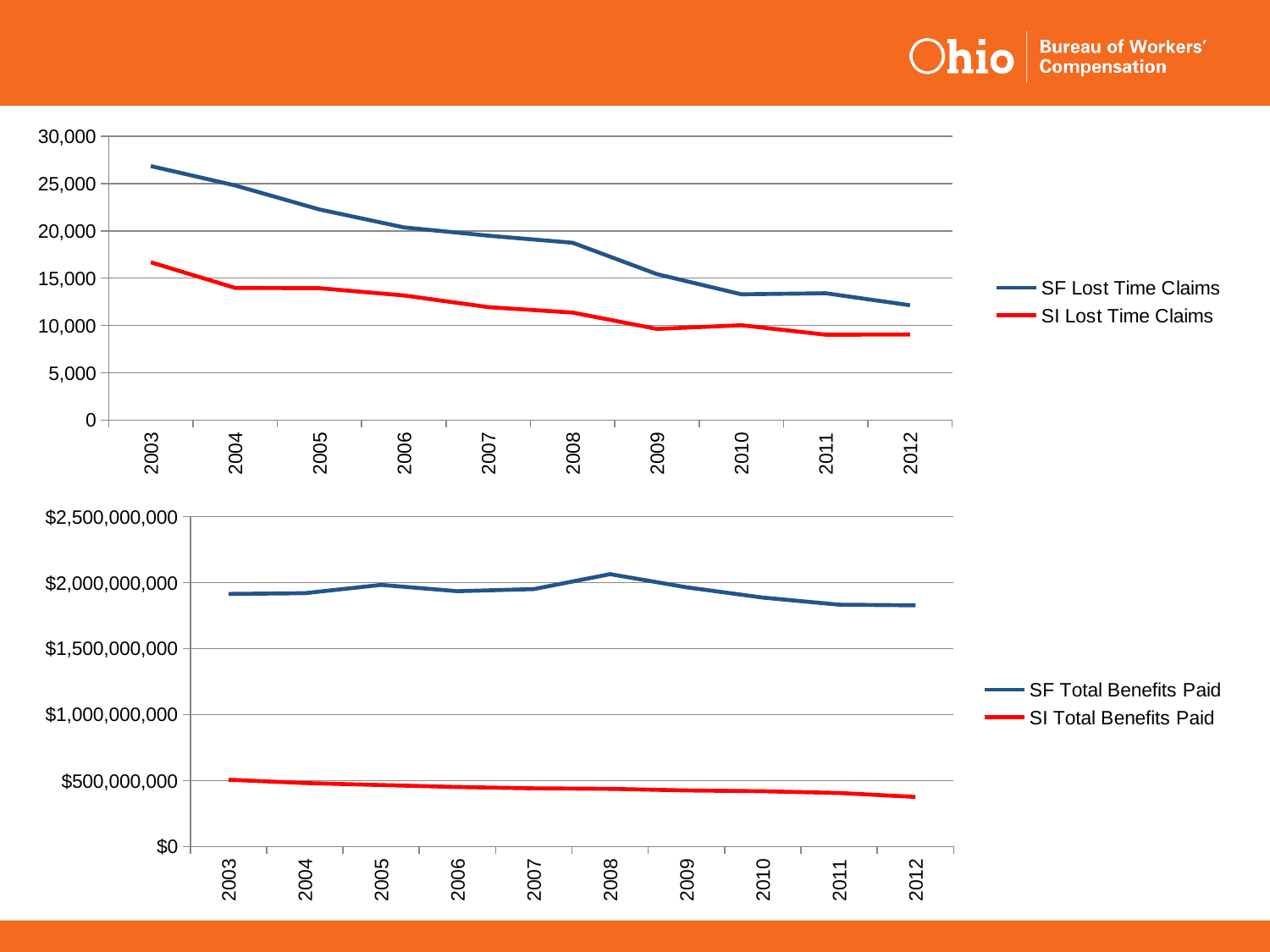
How many years are shown on the x axis of the bottom chart? 10 In the top chart, is the value for SI Lost Time Claims in 2012 greater or less than 10,000? less In the bottom chart, is the value for SI Total Benefits Paid in 2012 greater or less than $500,000,000? less In the top chart, which series is higher in 2008, SF Lost Time Claims or SI Lost Time Claims? SF Lost Time Claims In the top chart, which year has the lowest value for SF Lost Time Claims? 2012 In the bottom chart, what colour is the line for SI Total Benefits Paid? red How many series does the legend of the top chart list? 2 In the top chart, do SF Lost Time Claims generally rise or fall from 2003 to 2012? fall What kind of chart is the top chart on the slide? line chart In the top chart, is the value for SF Lost Time Claims in 2003 greater or less than 25,000? greater In the bottom chart, which year has the highest value for SF Total Benefits Paid? 2008 In the top chart, which year has the highest value for SF Lost Time Claims? 2003